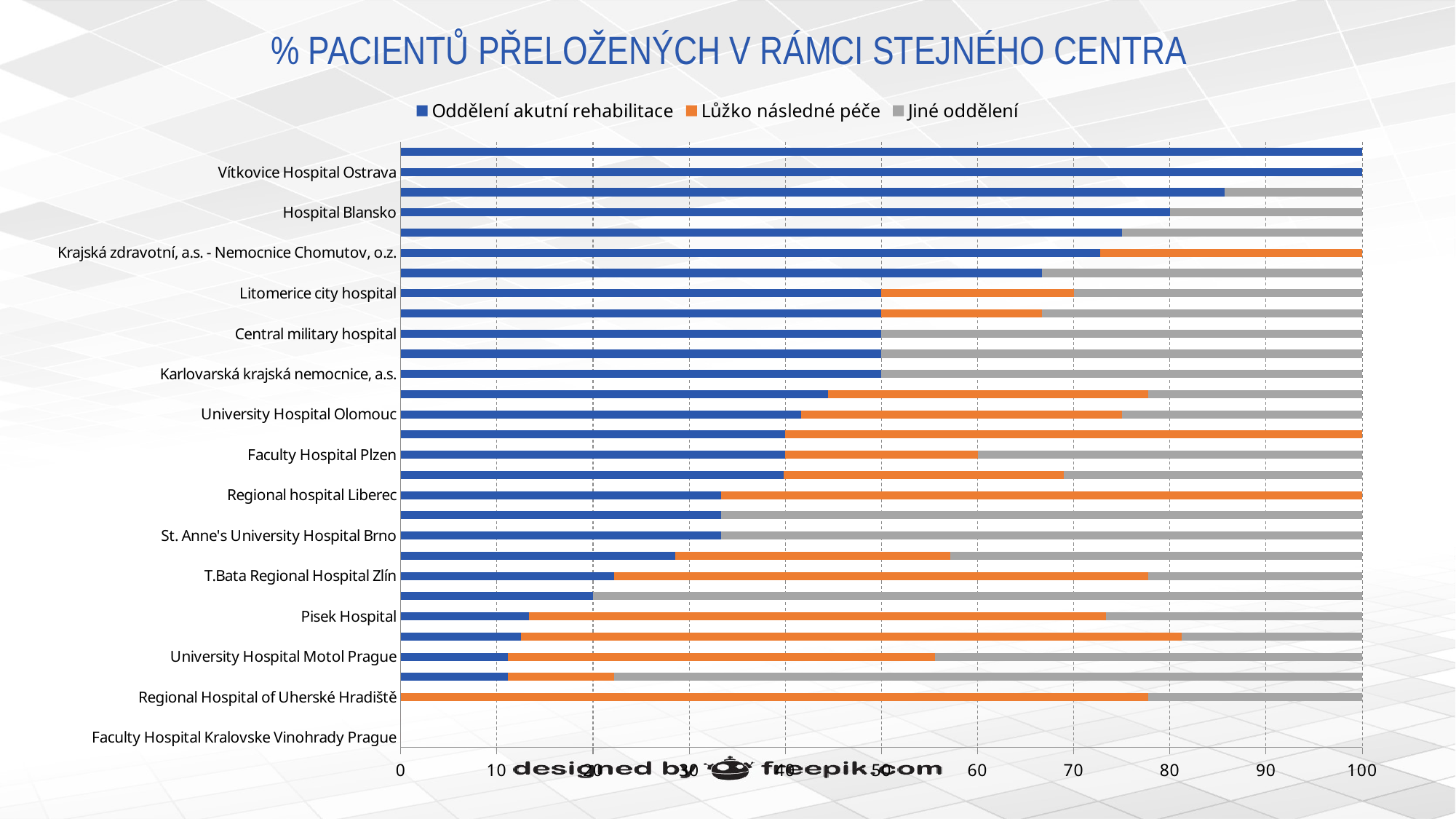
Is the Oddělení akutní rehabilitace value for Regional hospital Liberec greater or less than 40? less Which has the larger Oddělení akutní rehabilitace value, Hospital Blansko or University Hospital Motol Prague? Hospital Blansko Which has the larger Jiné oddělení value, St. Anne's University Hospital Brno or Hospital Blansko? St. Anne's University Hospital Brno What kind of chart is shown on the slide? Stacked bar chart Which has the larger Lůžko následné péče value, Regional Hospital of Uherské Hradiště or University Hospital Motol Prague? Regional Hospital of Uherské Hradiště Is the Oddělení akutní rehabilitace value for Central military hospital greater or less than 40? greater Is the Oddělení akutní rehabilitace value for Pisek Hospital greater or less than 20? less Which colour represents the series Lůžko následné péče? Orange How many series does the legend list? 3 What is the title of the chart? % PACIENTŮ PŘELOŽENÝCH V RÁMCI STEJNÉHO CENTRA